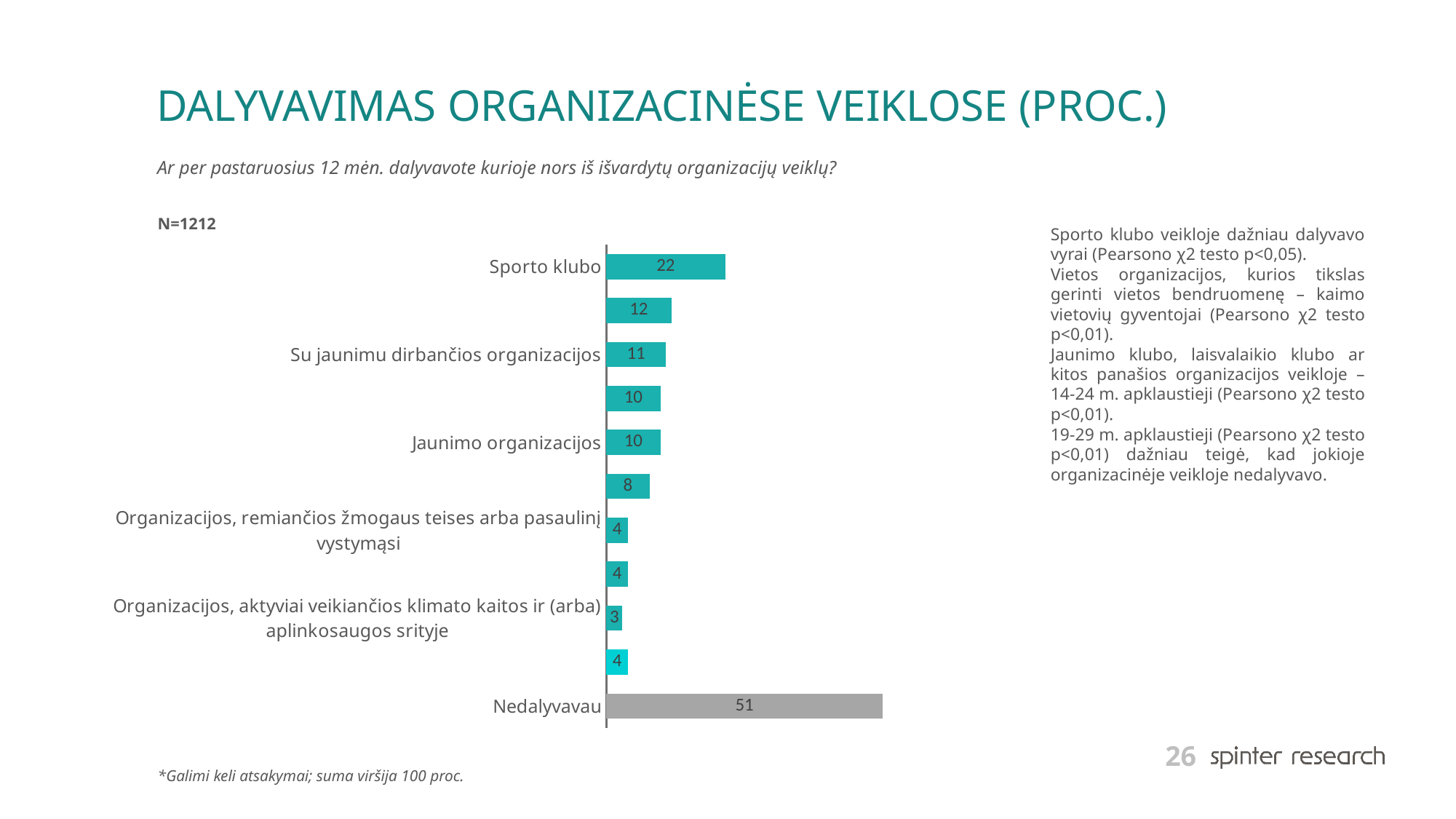
Which is larger, the value for Sporto klubo or the value for Jaunimo organizacijos? Sporto klubo What is the difference between the values for Nedalyvavau and Sporto klubo? 29 What kind of chart is shown on the slide? Bar chart How many bars are plotted in the chart? 11 Which category has the highest value? Nedalyvavau What is the title of the slide? DALYVAVIMAS ORGANIZACINĖSE VEIKLOSE (PROC.) What is the value for Organizacijos, aktyviai veikiančios klimato kaitos ir (arba) aplinkosaugos srityje? 3 What is the value for Su jaunimu dirbančios organizacijos? 11 What is the value for Jaunimo organizacijos? 10 What is the value for Nedalyvavau? 51 What is the value for Sporto klubo? 22 Which category has the lowest value? Organizacijos, aktyviai veikiančios klimato kaitos ir (arba) aplinkosaugos srityje